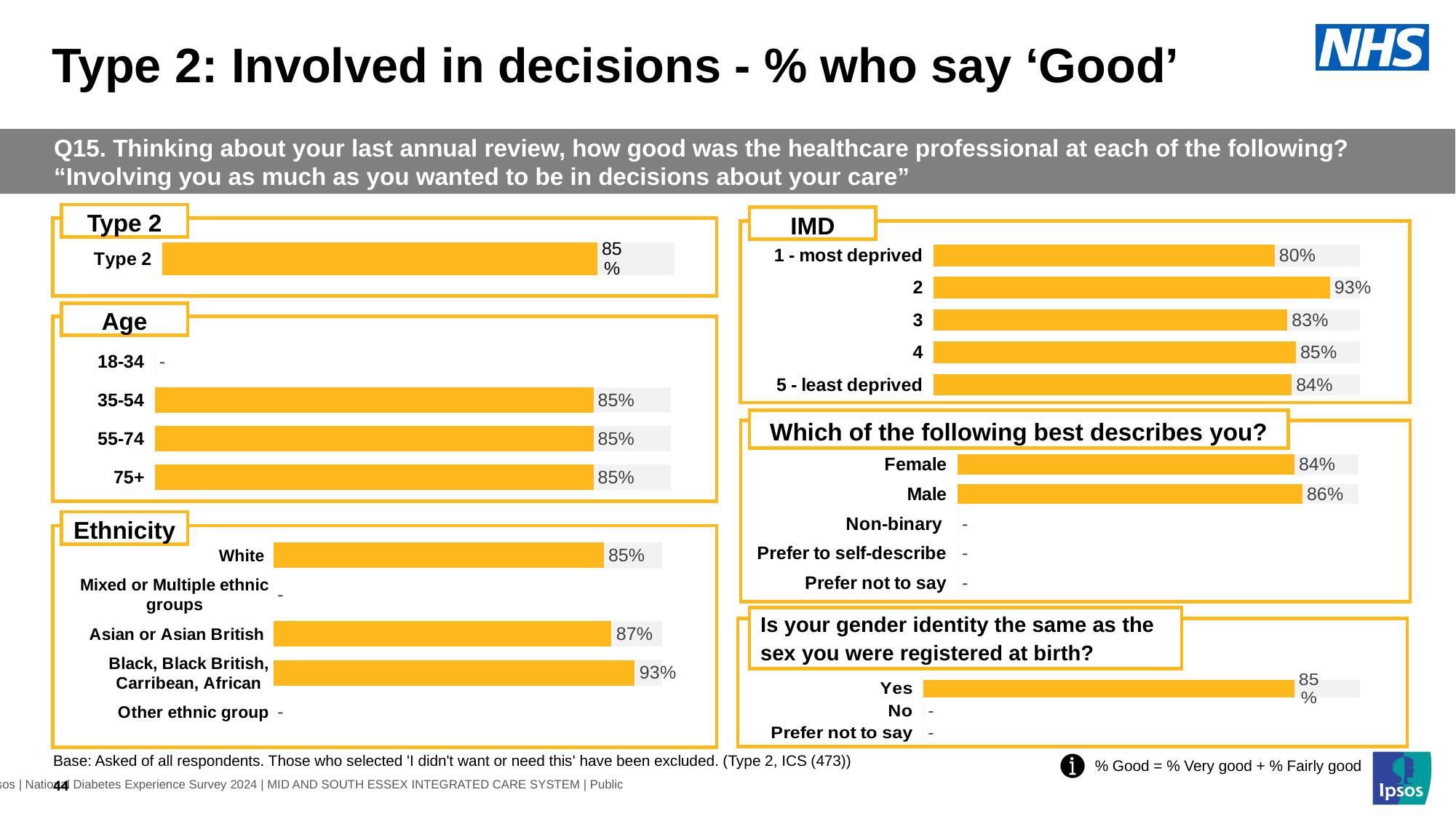
In the 'Which of the following best describes you?' chart, which is larger, the value for Female or the value for Male? Male In the Ethnicity chart, what is the difference between the values for Black, Black British, Carribean, African and White? 8 percentage points What type of chart is used in the IMD section? Bar chart In the IMD chart, what is the value for 5 - least deprived? 84% In the 'Is your gender identity the same as the sex you were registered at birth?' chart, what is the value for Yes? 85% In the IMD chart, which IMD group has the highest value? 2 In the Type 2 chart, what percentage of Type 2 respondents say 'Good'? 85% In the Ethnicity chart, which ethnic group with a plotted bar has the highest value? Black, Black British, Carribean, African In the Age chart, what is the value for the 55-74 age group? 85% In the IMD chart, which IMD group has the lowest value? 1 - most deprived In the Ethnicity chart, what is the value for Asian or Asian British? 87% In the IMD chart, what is the difference between the values for IMD group 2 and IMD group 3? 10 percentage points